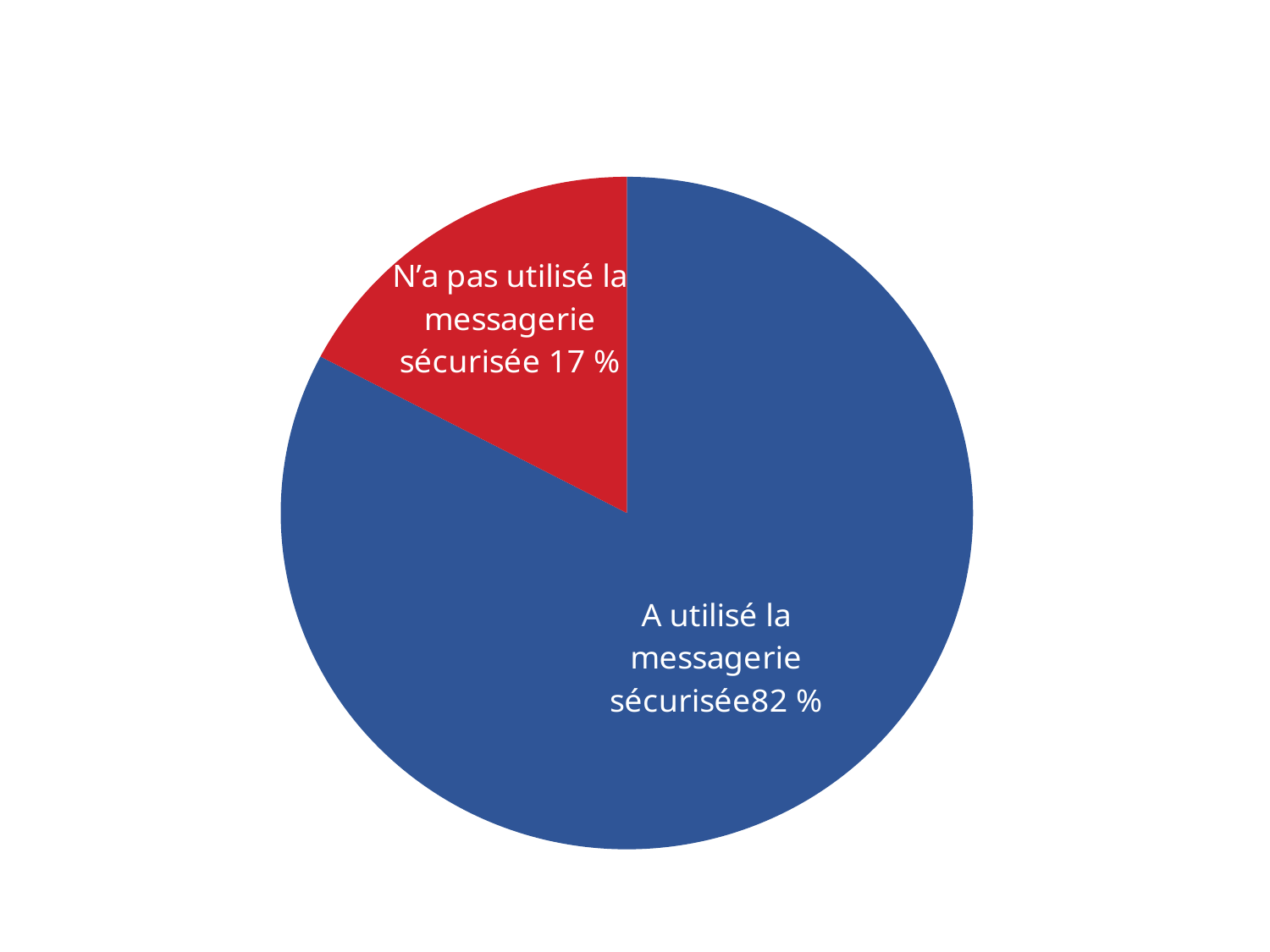
What is the difference in percentage points between the "A utilisé la messagerie sécurisée" slice and the "N'a pas utilisé la messagerie sécurisée" slice? 65 Which slice of the pie is the smallest? N'a pas utilisé la messagerie sécurisée What colour is the slice labelled "N'a pas utilisé la messagerie sécurisée"? red What share of the pie is labelled "A utilisé la messagerie sécurisée"? 82 % What kind of chart is shown on the slide? pie chart Which slice of the pie is the largest? A utilisé la messagerie sécurisée Which is larger: the share for "A utilisé la messagerie sécurisée" or the share for "N'a pas utilisé la messagerie sécurisée"? A utilisé la messagerie sécurisée What colour is the slice labelled "A utilisé la messagerie sécurisée"? blue How many slices does the pie chart have? 2 What share of the pie is labelled "N'a pas utilisé la messagerie sécurisée"? 17 %